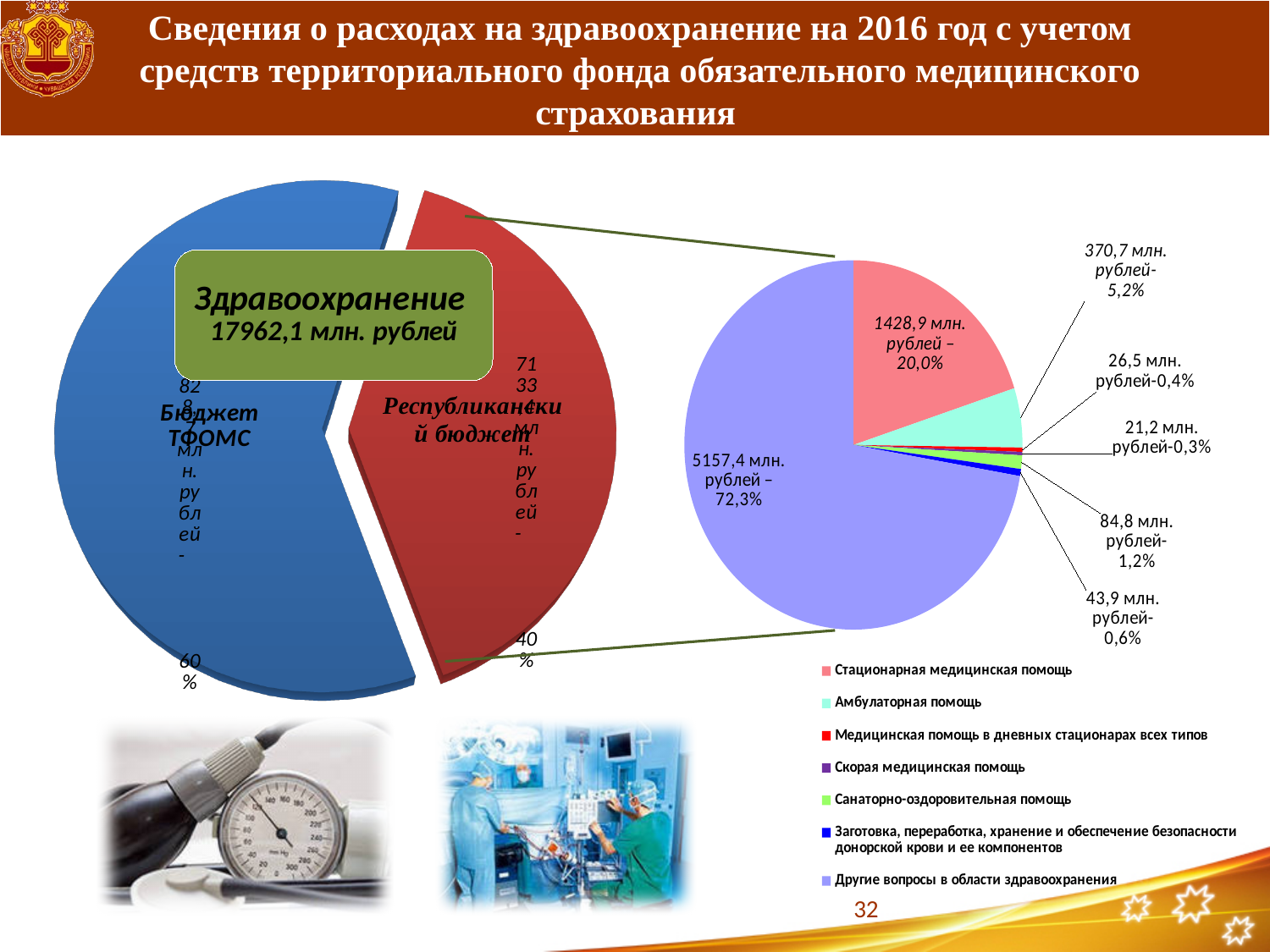
On the left pie chart, what share does Бюджет ТФОМС have? 60% On the right pie chart, what value is shown for Стационарная медицинская помощь? 1428,9 млн. рублей – 20,0% What kind of chart is the chart on the right of the slide? Pie chart On the right pie chart, which is larger: Санаторно-оздоровительная помощь or Заготовка, переработка, хранение и обеспечение безопасности донорской крови и ее компонентов? Санаторно-оздоровительная помощь On the right pie chart, what is the difference in млн. рублей between Стационарная медицинская помощь and Амбулаторная помощь? 1058,2 млн. рублей On the right pie chart, what value is shown for Амбулаторная помощь? 370,7 млн. рублей - 5,2% On the right pie chart, which category has the smallest slice? Скорая медицинская помощь On the left pie chart, which is larger: Бюджет ТФОМС or Республиканский бюджет? Бюджет ТФОМС On the right pie chart, what share does Другие вопросы в области здравоохранения have? 72,3% On the right pie chart, which category has the largest slice? Другие вопросы в области здравоохранения How many categories does the legend of the right pie chart list? 7 What total amount for Здравоохранение is shown in the box on the left pie chart? 17962,1 млн. рублей